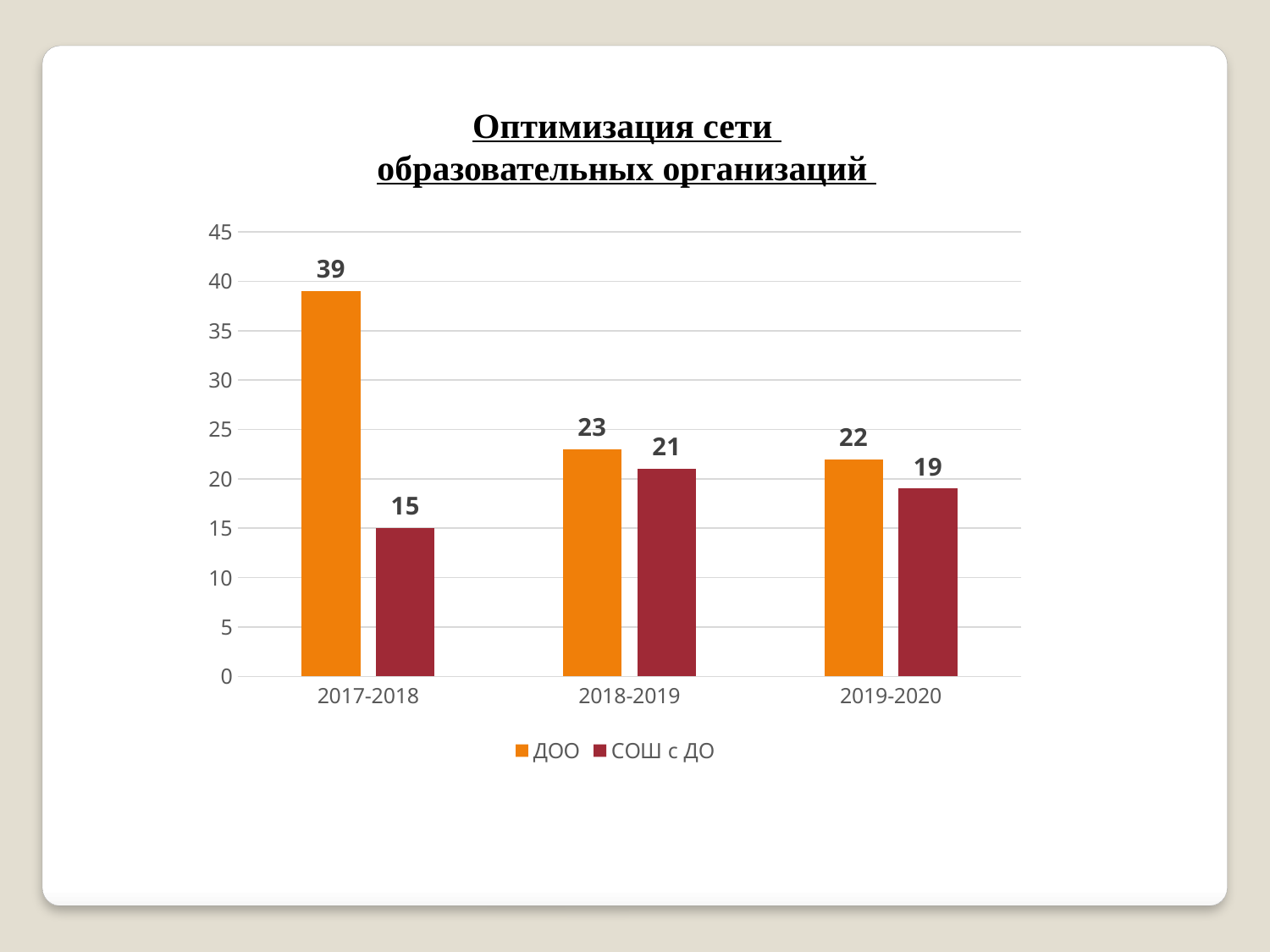
In which period is the ДОО value highest? 2017-2018 Is the value for ДОО in 2018-2019 greater or less than 20? greater What is the value for СОШ с ДО in 2018-2019? 21 Does the ДОО value rise or fall from 2017-2018 to 2018-2019? fall How many periods are shown on the x axis? 3 What is the value for СОШ с ДО in 2019-2020? 19 In which period is the СОШ с ДО value lowest? 2017-2018 What is the value for ДОО in 2017-2018? 39 Which is larger in 2019-2020, ДОО or СОШ с ДО? ДОО What kind of chart is shown on the slide? bar chart How many series does the legend list? 2 What is the difference between the ДОО and СОШ с ДО values in 2017-2018? 24